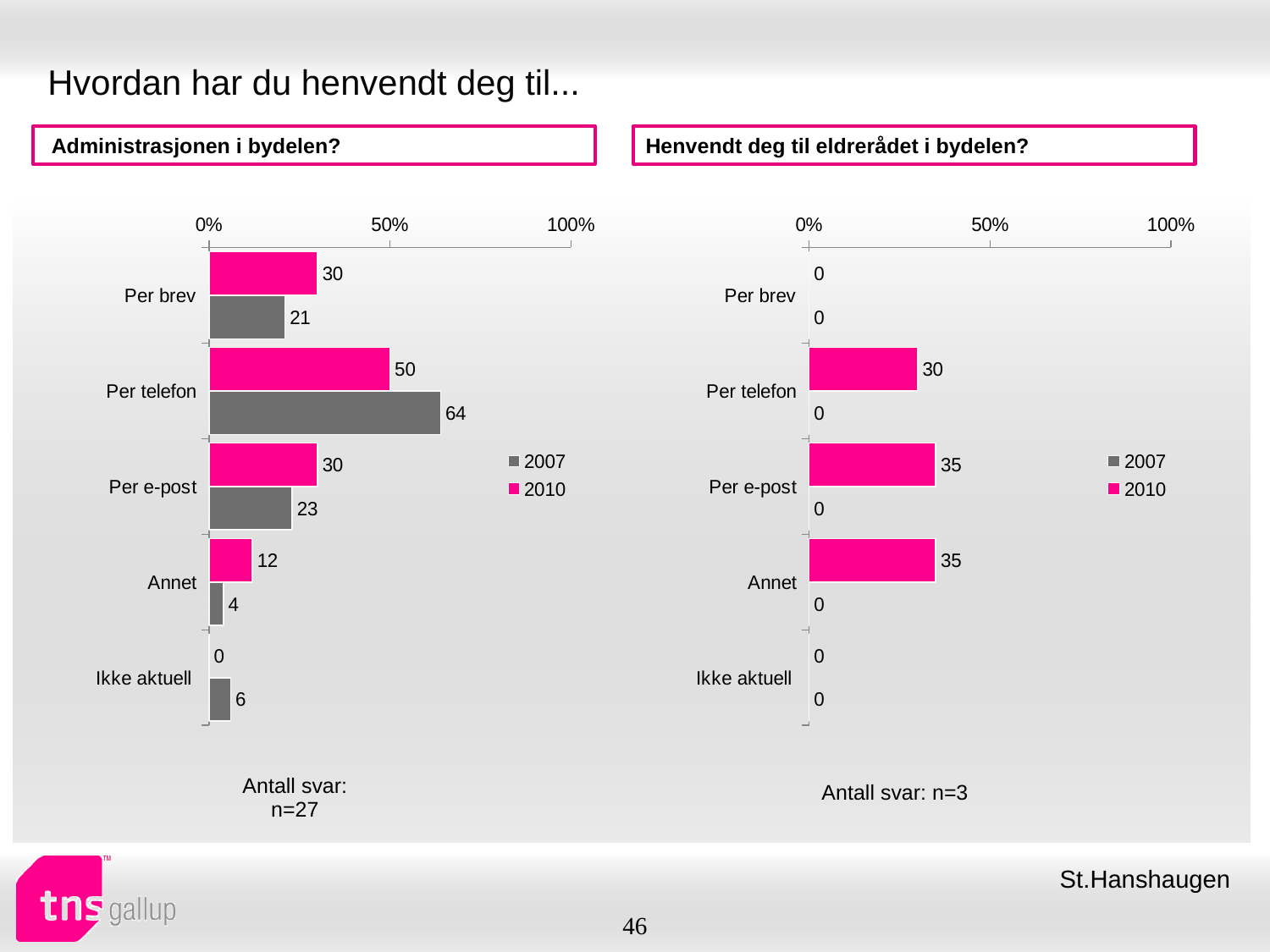
In the 'Henvendt deg til eldrerådet i bydelen?' chart, what is the value for Per telefon in 2007? 0 How many series does the legend of the 'Administrasjonen i bydelen?' chart list? 2 In the 'Administrasjonen i bydelen?' chart, which is larger for Per brev: the 2007 value or the 2010 value? 2010 What kind of chart is the 'Administrasjonen i bydelen?' chart? Bar chart In the 'Administrasjonen i bydelen?' chart, which category has the highest 2010 value? Per telefon How many categories are shown in the 'Henvendt deg til eldrerådet i bydelen?' chart? 5 In the 'Administrasjonen i bydelen?' chart, which category has the lowest 2007 value? Annet In the 'Henvendt deg til eldrerådet i bydelen?' chart, what is the value for Per e-post in 2010? 35 In the 'Administrasjonen i bydelen?' chart, what is the value for Annet in 2010? 12 In the 'Henvendt deg til eldrerådet i bydelen?' chart, which is larger for Per telefon: the 2007 value or the 2010 value? 2010 In the 'Administrasjonen i bydelen?' chart, what is the value for Per telefon in 2007? 64 In the 'Administrasjonen i bydelen?' chart, what is the difference between the 2007 and 2010 values for Per telefon? 14